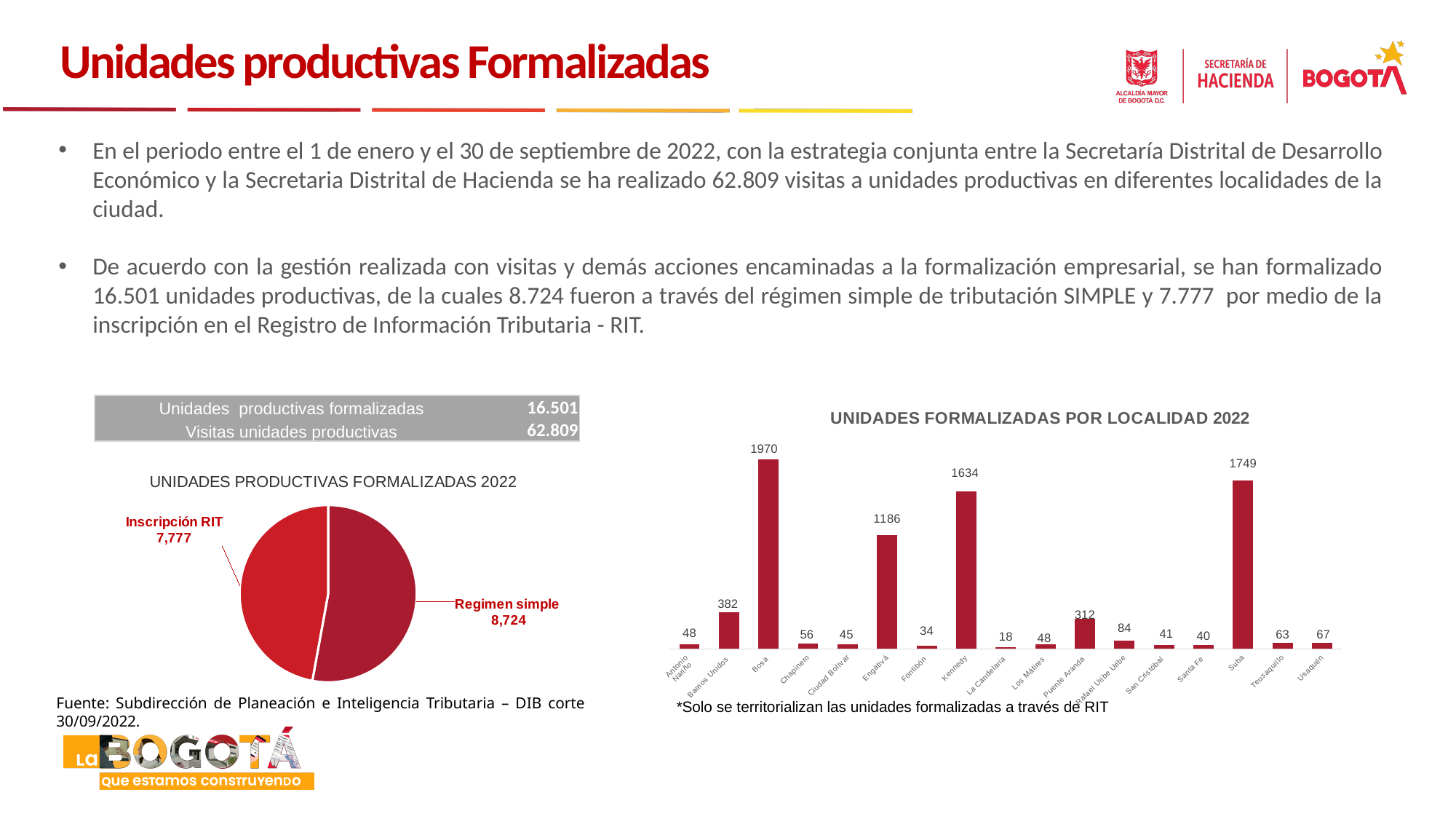
What kind of chart is the one titled UNIDADES FORMALIZADAS POR LOCALIDAD 2022? bar chart In the chart titled UNIDADES FORMALIZADAS POR LOCALIDAD 2022, which locality has the lowest value? La Candelaria In the chart titled UNIDADES FORMALIZADAS POR LOCALIDAD 2022, which locality has the highest value? Bosa In the pie chart titled UNIDADES PRODUCTIVAS FORMALIZADAS 2022, what is the value for Inscripción RIT? 7,777 In the pie chart titled UNIDADES PRODUCTIVAS FORMALIZADAS 2022, what is the difference between Regimen simple and Inscripción RIT? 947 In the chart titled UNIDADES FORMALIZADAS POR LOCALIDAD 2022, which is larger, the value for Engativá or the value for Puente Aranda? Engativá In the pie chart titled UNIDADES PRODUCTIVAS FORMALIZADAS 2022, which slice is larger, Regimen simple or Inscripción RIT? Regimen simple What kind of chart is the one titled UNIDADES PRODUCTIVAS FORMALIZADAS 2022? pie chart In the chart titled UNIDADES FORMALIZADAS POR LOCALIDAD 2022, what is the difference between the values for Bosa and Suba? 221 In the chart titled UNIDADES FORMALIZADAS POR LOCALIDAD 2022, what is the value for Kennedy? 1634 In the chart titled UNIDADES FORMALIZADAS POR LOCALIDAD 2022, what is the value for Bosa? 1970 In the chart titled UNIDADES FORMALIZADAS POR LOCALIDAD 2022, how many localities are shown? 17